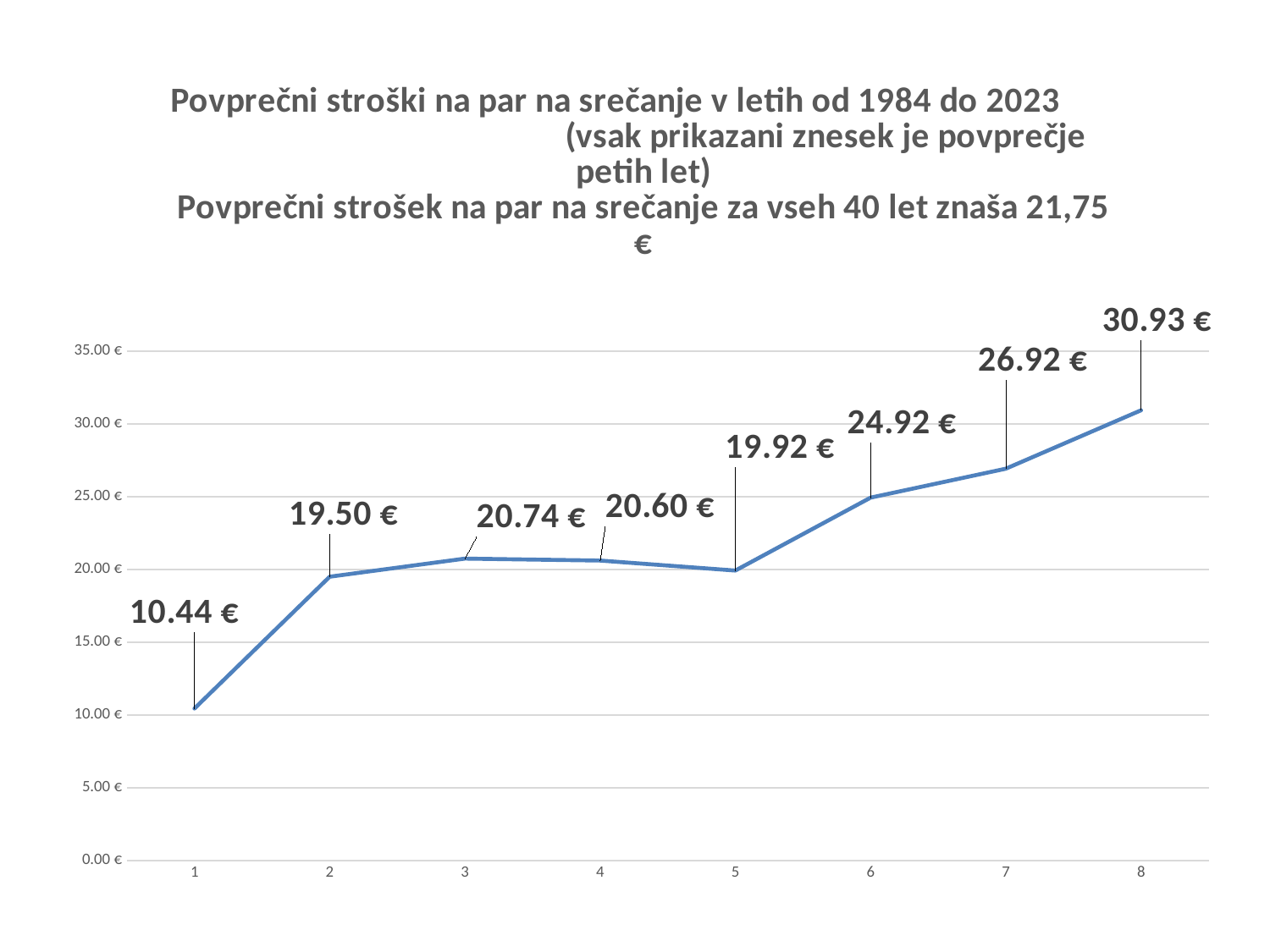
Which is larger, the value at point 3 or the value at point 4? point 3 Which point has the lowest value? 1 What kind of chart is shown on the slide? line chart Is the value at point 6 greater or less than 20.00 €? greater According to the chart title, what is the average cost per pair per meeting over all 40 years? 21,75 € What is the difference between the values at point 8 and point 1? 20.49 € Do the values generally rise or fall from point 1 to point 8? rise Which point has the highest value? 8 How many data points are plotted on the chart? 8 What is the value at point 8? 30.93 € What is the value at point 5? 19.92 € What is the value at point 1? 10.44 €